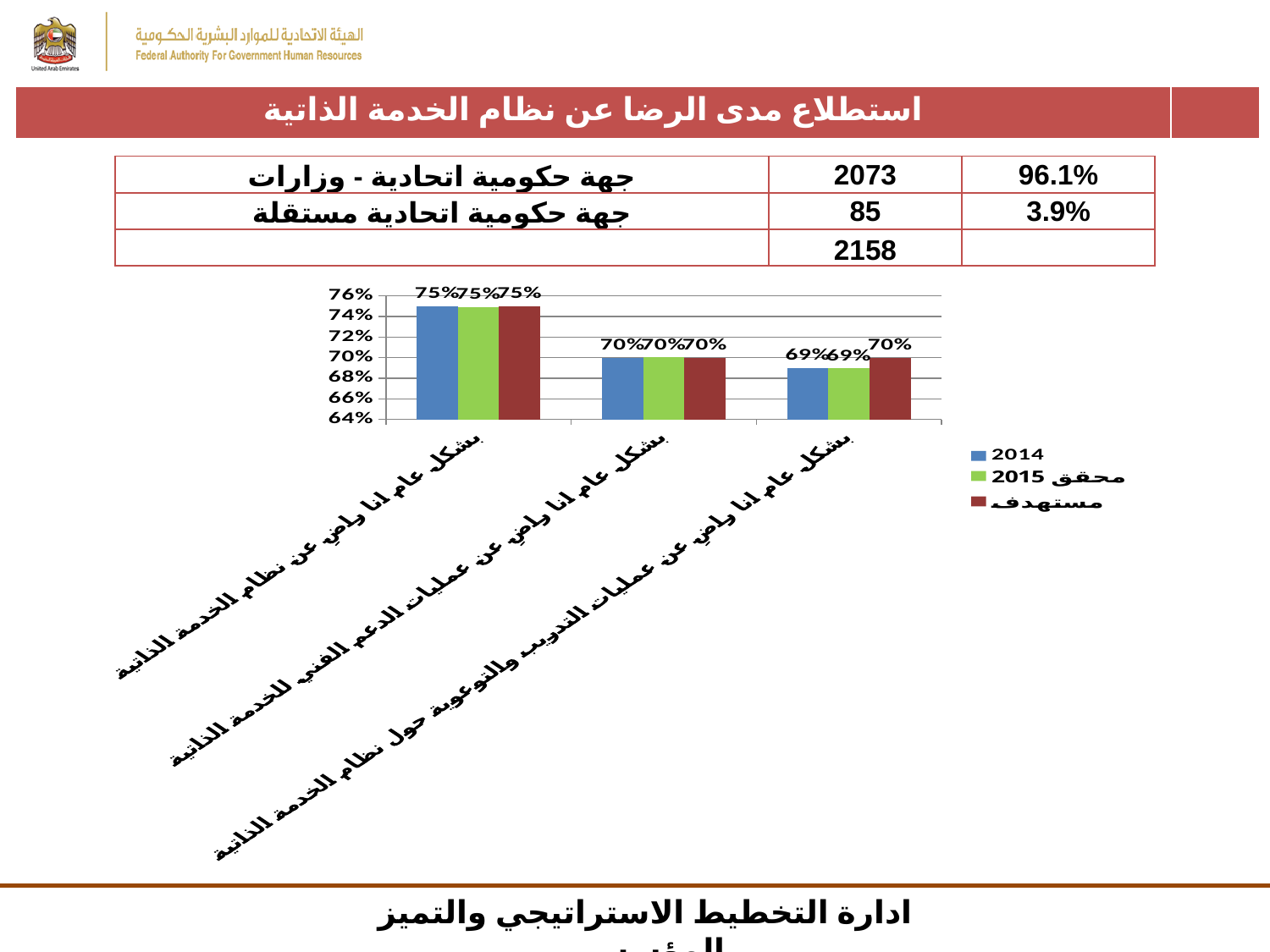
What is the محقق 2015 value for the second category (technical support operations)? 70% Which category has the lowest محقق 2015 value? the third category (training and awareness on the self-service system) What is the مستهدف (target) value for the third category (training and awareness on the self-service system)? 70% What is the 2014 value for the first category (overall satisfaction with the self-service system)? 75% How many categories are plotted on the x axis of the chart? 3 Do the 2014 values rise or fall from the first category to the third category? fall Which category has the highest 2014 value? the first category (overall satisfaction with the self-service system) What is the difference between the 2014 value for the first category and the 2014 value for the second category? 5% For the third category, is the مستهدف (target) value larger or smaller than the 2014 value? larger What is the 2014 value for the third category (training and awareness on the self-service system)? 69% How many series does the chart legend list? 3 What kind of chart is shown on the slide? bar chart